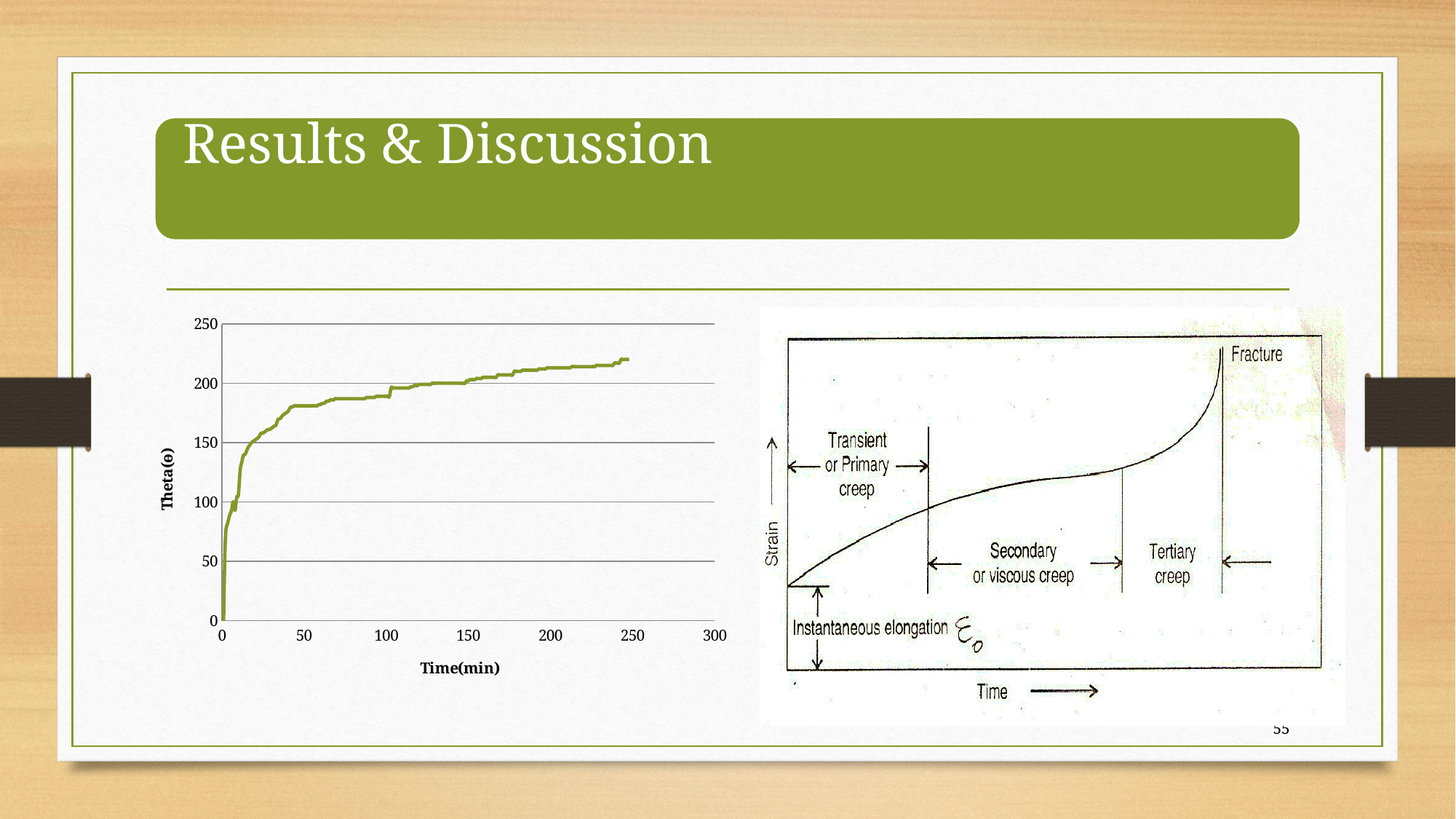
In the left chart, is the value of Theta at 150 min greater or less than 150? greater In the left chart, is the value of Theta at 200 min greater or less than 200? greater What kind of chart is the left chart plotting Theta against Time(min)? line chart What is the maximum value shown on the y axis of the left chart? 250 What is the label of the x axis of the left chart? Time(min) In the left chart, is the value of Theta at 75 min greater or less than 100? greater In the right chart, does Strain rise or fall as Time increases? rise In the left chart, does Theta rise or fall as Time(min) increases? rise